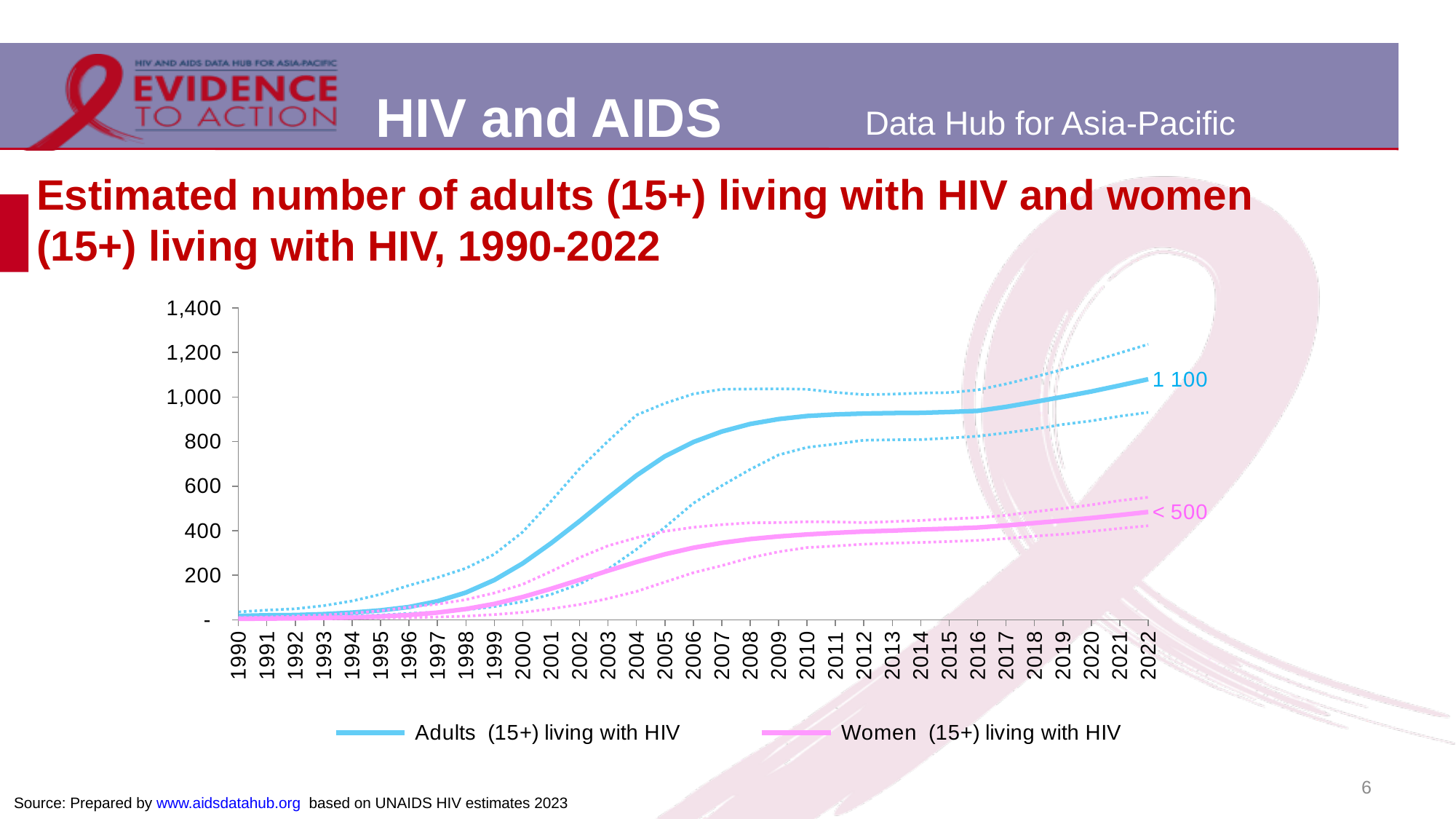
Does the number of Adults (15+) living with HIV rise or fall from 1990 to 2022? Rise How many years are shown along the x axis? 33 Is the value for Women (15+) living with HIV in 2005 greater or less than 400? less What is the labelled value for Adults (15+) living with HIV in 2022? 1 100 What is the labelled value for Women (15+) living with HIV in 2022? < 500 Is the value for Adults (15+) living with HIV in 2005 greater or less than 600? greater In which year is the Adults (15+) living with HIV series at its highest? 2022 How many series does the legend list? 2 What colour is the line for Women (15+) living with HIV? Pink Is the value for Adults (15+) living with HIV in 2010 greater or less than 800? greater In 2022, which series has the larger value: Adults (15+) living with HIV or Women (15+) living with HIV? Adults (15+) living with HIV What kind of chart is shown on the slide? Line chart